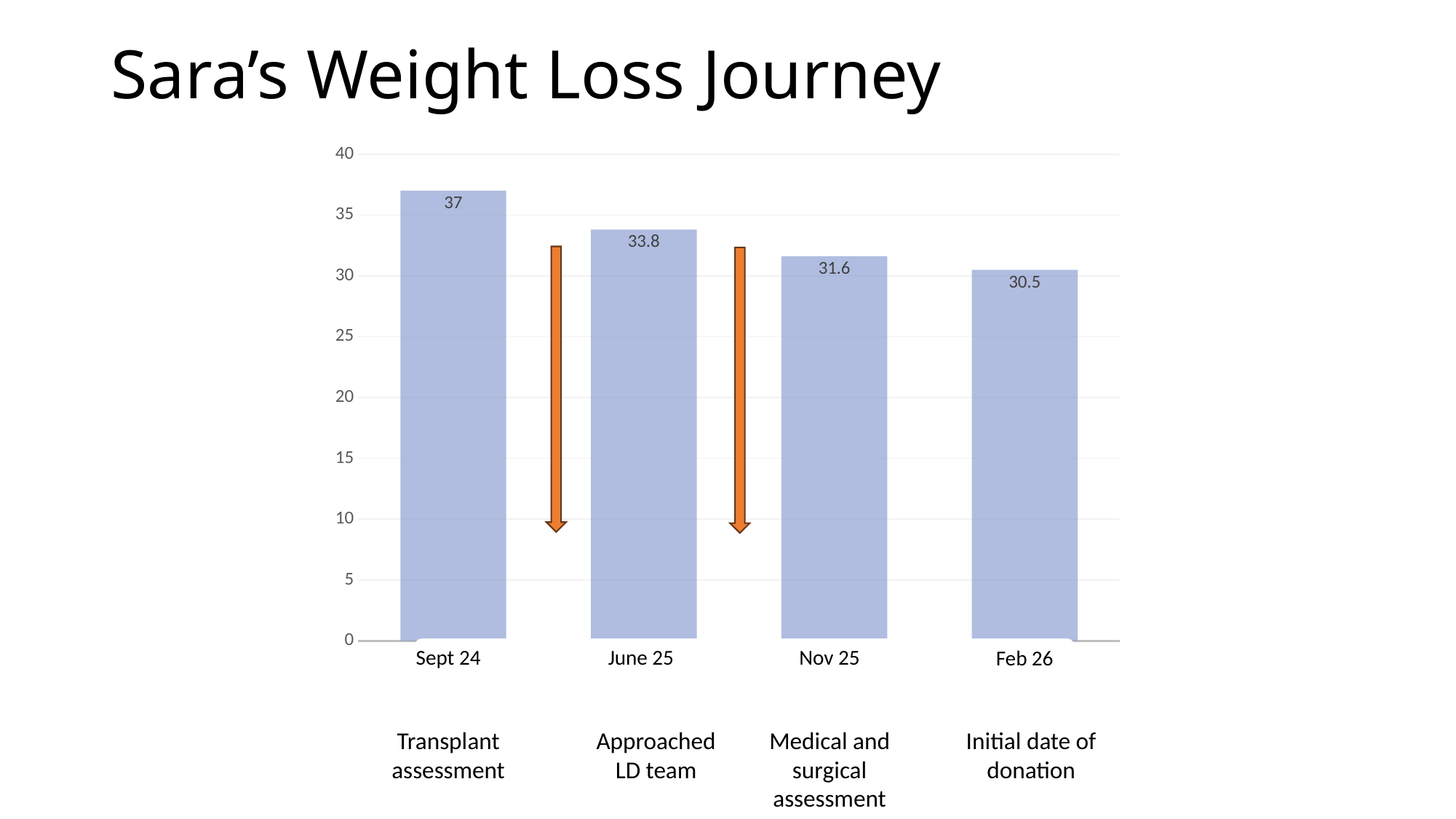
Do the values rise or fall from Sept 24 to Feb 26? fall How many categories are shown on the x axis? 4 What is the value for Nov 25? 31.6 Which category has the lowest value? Feb 26 What is the value for June 25? 33.8 What is the value for Sept 24? 37 What is the difference between the values for June 25 and Nov 25? 2.2 Which is larger, the value for June 25 or the value for Nov 25? June 25 Which category has the highest value? Sept 24 What is the difference between the values for Sept 24 and Feb 26? 6.5 What kind of chart is shown on the slide? bar chart What is the value for Feb 26? 30.5